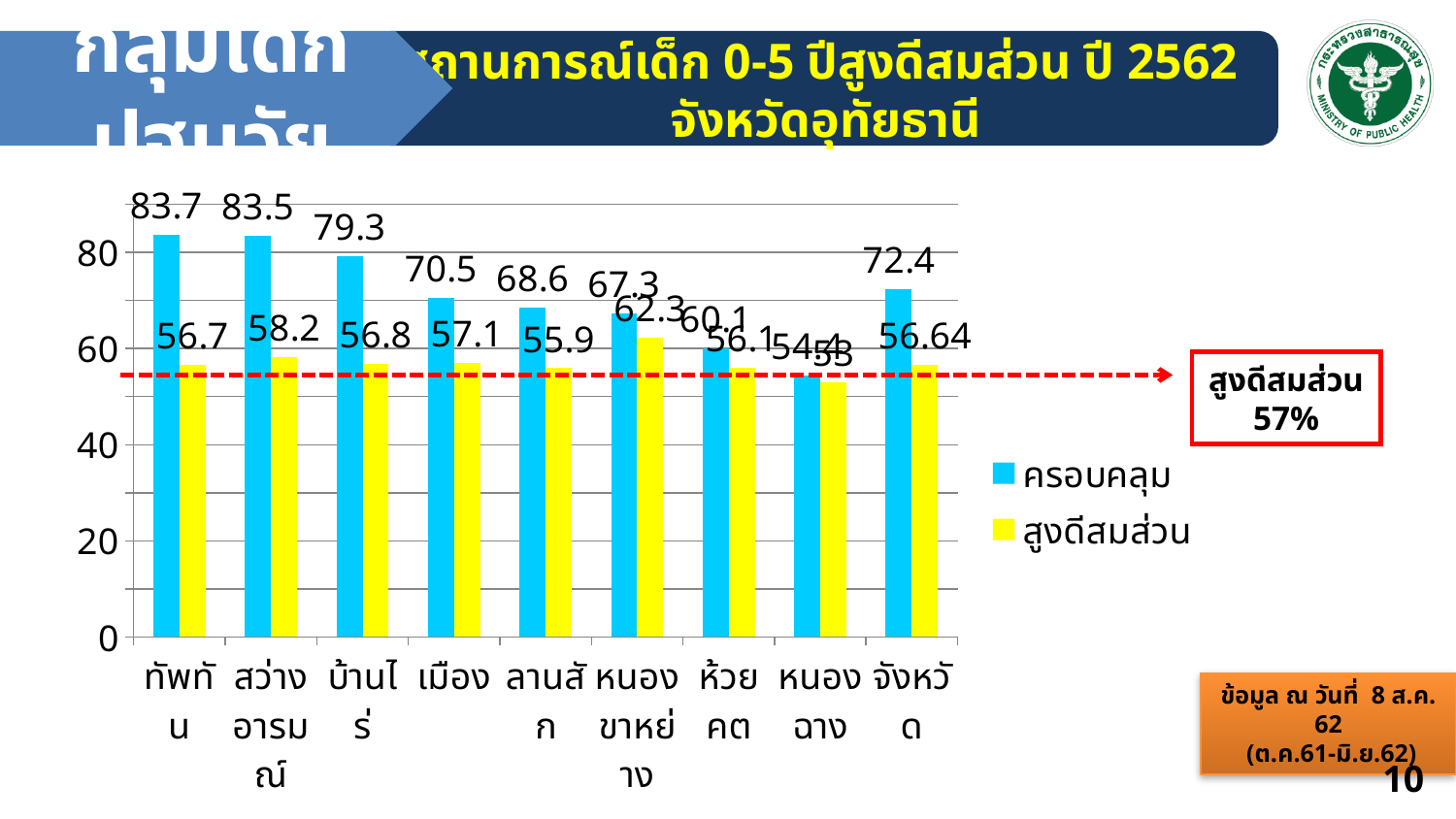
Which is larger, the ครอบคลุม value for เมือง or the ครอบคลุม value for ลานสัก? เมือง Which category has the lowest ครอบคลุม value? หนองฉาง What is the สูงดีสมส่วน value for หนองขาหย่าง? 62.3 How many series does the legend list? 2 What target percentage is shown in the red box next to the dashed line? 57% What is the ครอบคลุม value for จังหวัด? 72.4 What is the ครอบคลุม value for ทัพทัน? 83.7 What is the difference between the ครอบคลุม and สูงดีสมส่วน values for บ้านไร่? 22.5 Which category has the highest สูงดีสมส่วน value? หนองขาหย่าง What type of chart is shown on the slide? bar chart Is the ครอบคลุม value for ห้วยคต greater or less than 80? less What is the สูงดีสมส่วน value for จังหวัด? 56.64